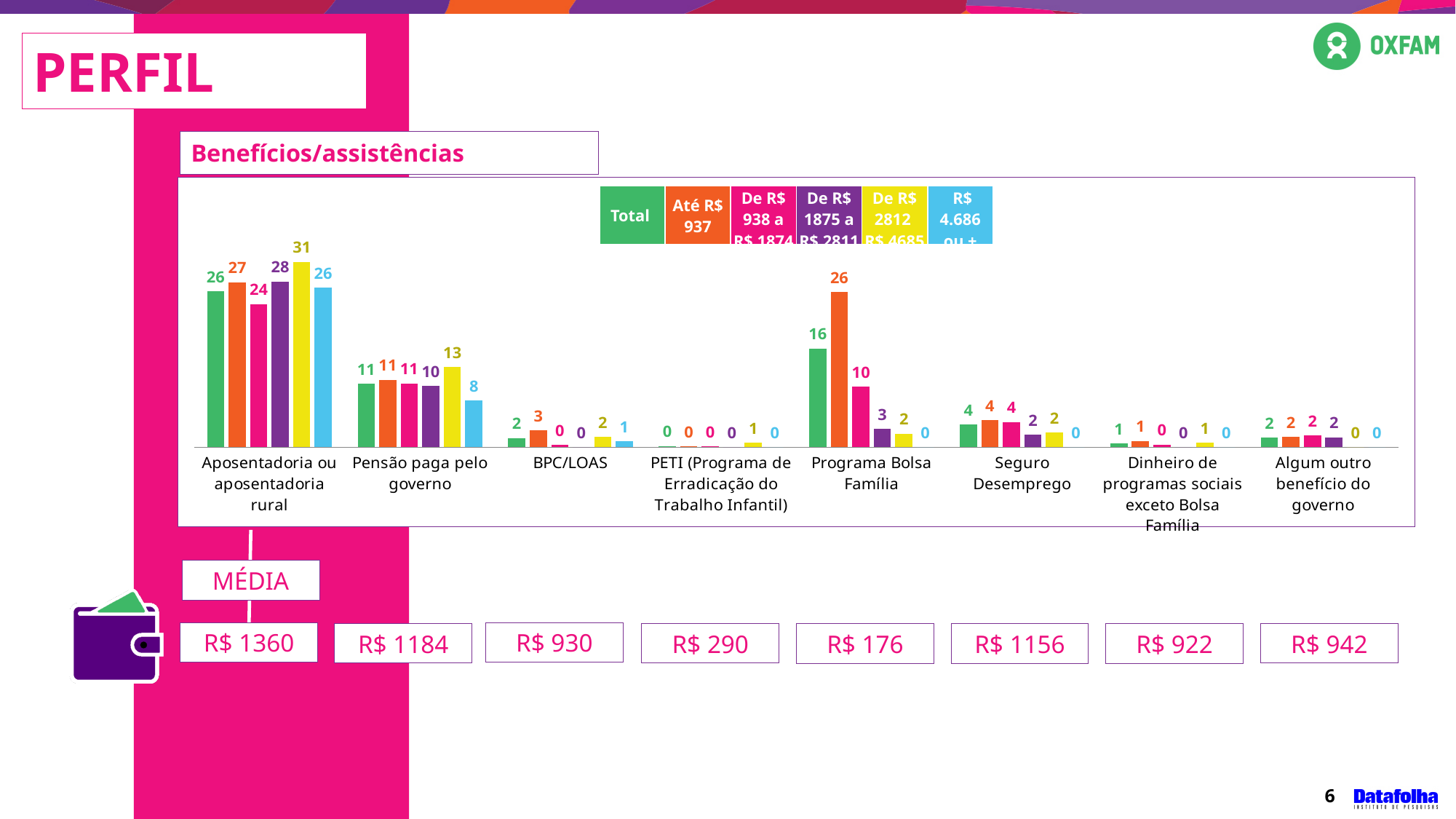
What is the difference between the Total values for Aposentadoria ou aposentadoria rural and Pensão paga pelo governo? 15 What is the difference between the Até R$ 937 value and the R$ 4.686 ou + value for Programa Bolsa Família? 26 What kind of chart is shown on the slide? Bar chart Which category has the lowest Total value? PETI (Programa de Erradicação do Trabalho Infantil) What is the Até R$ 937 value for Programa Bolsa Família? 26 How many series does the legend list? 6 Which category has the highest Total value? Aposentadoria ou aposentadoria rural What is the value for Aposentadoria ou aposentadoria rural in the De R$ 2812 a R$ 4685 series? 31 What is the value for Pensão paga pelo governo in the R$ 4.686 ou + series? 8 For Seguro Desemprego, which is larger: the Total value or the De R$ 1875 a R$ 2811 value? Total How many categories are shown on the x axis of the chart? 8 What is the Total value for Programa Bolsa Família? 16